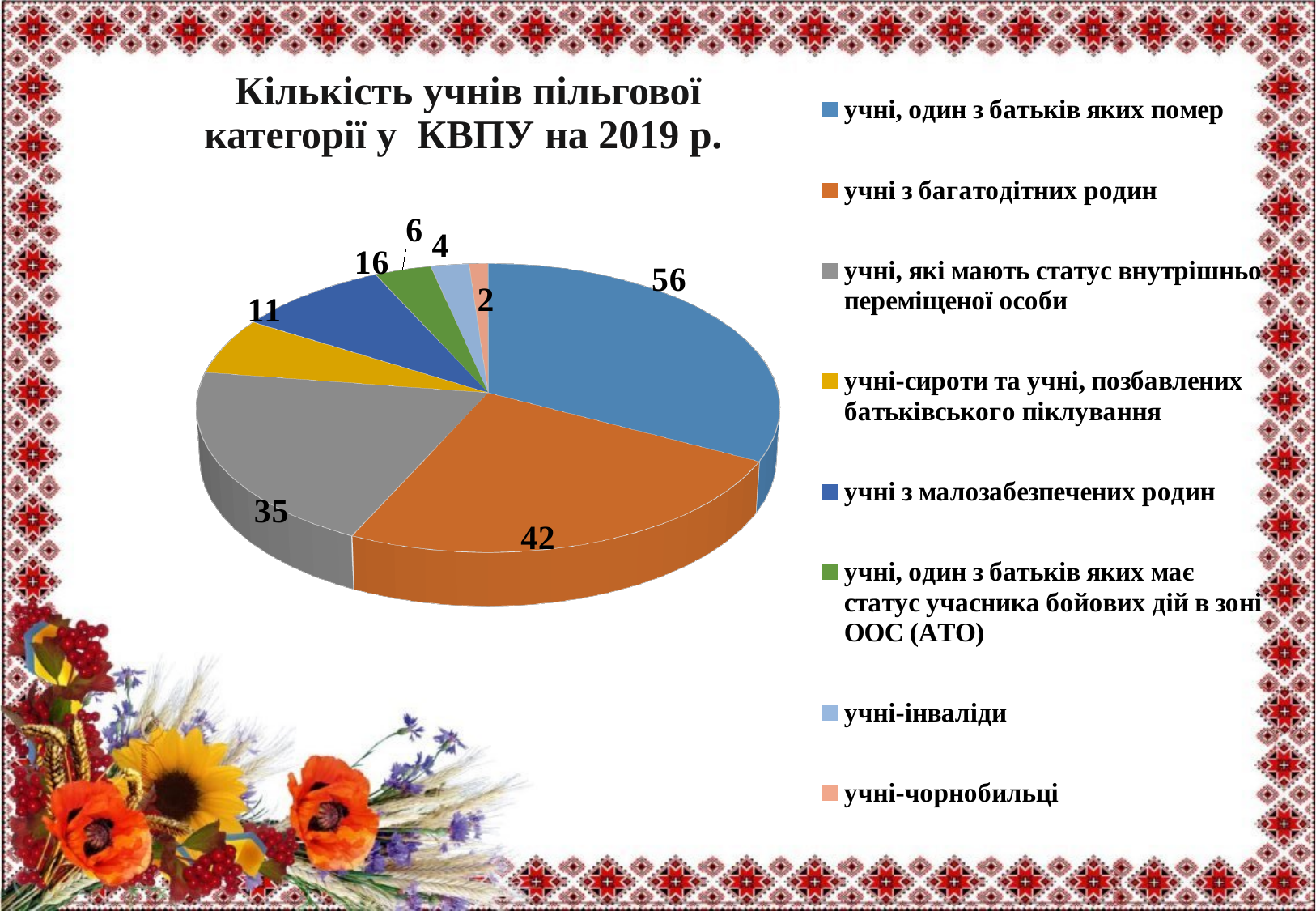
What is the value for "учні, які мають статус внутрішньо переміщеної особи"? 35 What is the difference between the values for "учні з багатодітних родин" and "учні з малозабезпечених родин"? 26 Which category has the smallest slice of the pie? учні-чорнобильці How many categories does the pie chart have? 8 What is the value for "учні-сироти та учні, позбавлених батьківського піклування"? 11 Which category has the largest slice of the pie? учні, один з батьків яких помер Which is larger: the value for "учні-інваліди" or the value for "учні, один з батьків яких має статус учасника бойових дій в зоні ООС (АТО)"? учні, один з батьків яких має статус учасника бойових дій в зоні ООС (АТО) What type of chart is shown on the slide? Pie chart What is the title of the chart? Кількість учнів пільгової категорії у КВПУ на 2019 р. What is the value for "учні, один з батьків яких помер"? 56 What is the value for "учні-чорнобильці"? 2 What is the value for "учні з багатодітних родин"? 42